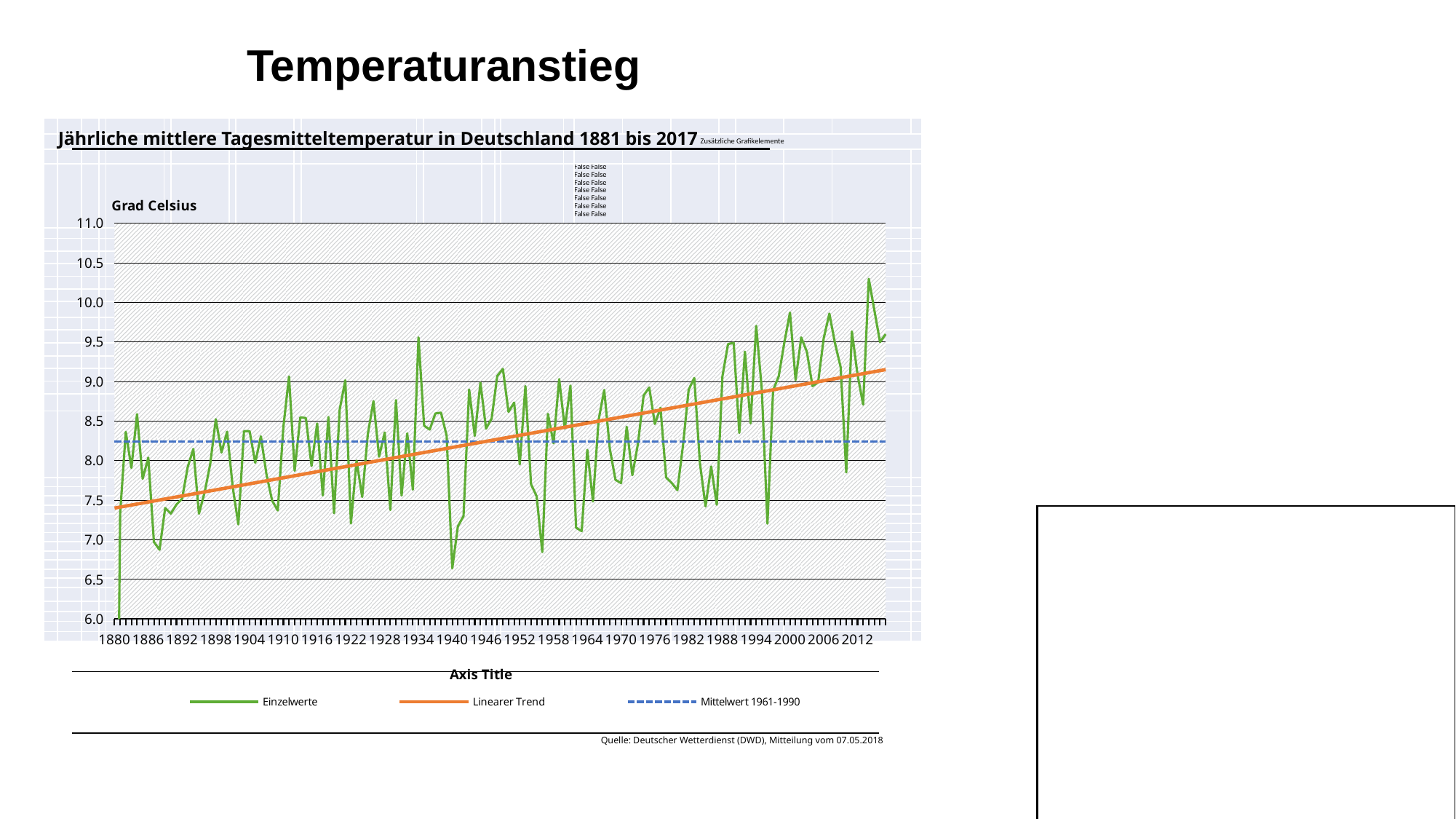
Which is larger at 2012: the Linearer Trend value or the Mittelwert 1961-1990 value? Linearer Trend How many series does the legend list? 3 Is the highest Einzelwerte value on the chart greater or less than 10.0? greater Does the Linearer Trend line rise or fall from 1880 to 2012? rise Is the value of the Mittelwert 1961-1990 line greater or less than 8.5? less What is the title of the chart? Jährliche mittlere Tagesmitteltemperatur in Deutschland 1881 bis 2017 What unit is shown as the label of the vertical axis? Grad Celsius Is the value of the Mittelwert 1961-1990 line greater or less than 8.0? greater How many year labels are printed on the horizontal axis? 23 What kind of chart is shown on the slide? line chart